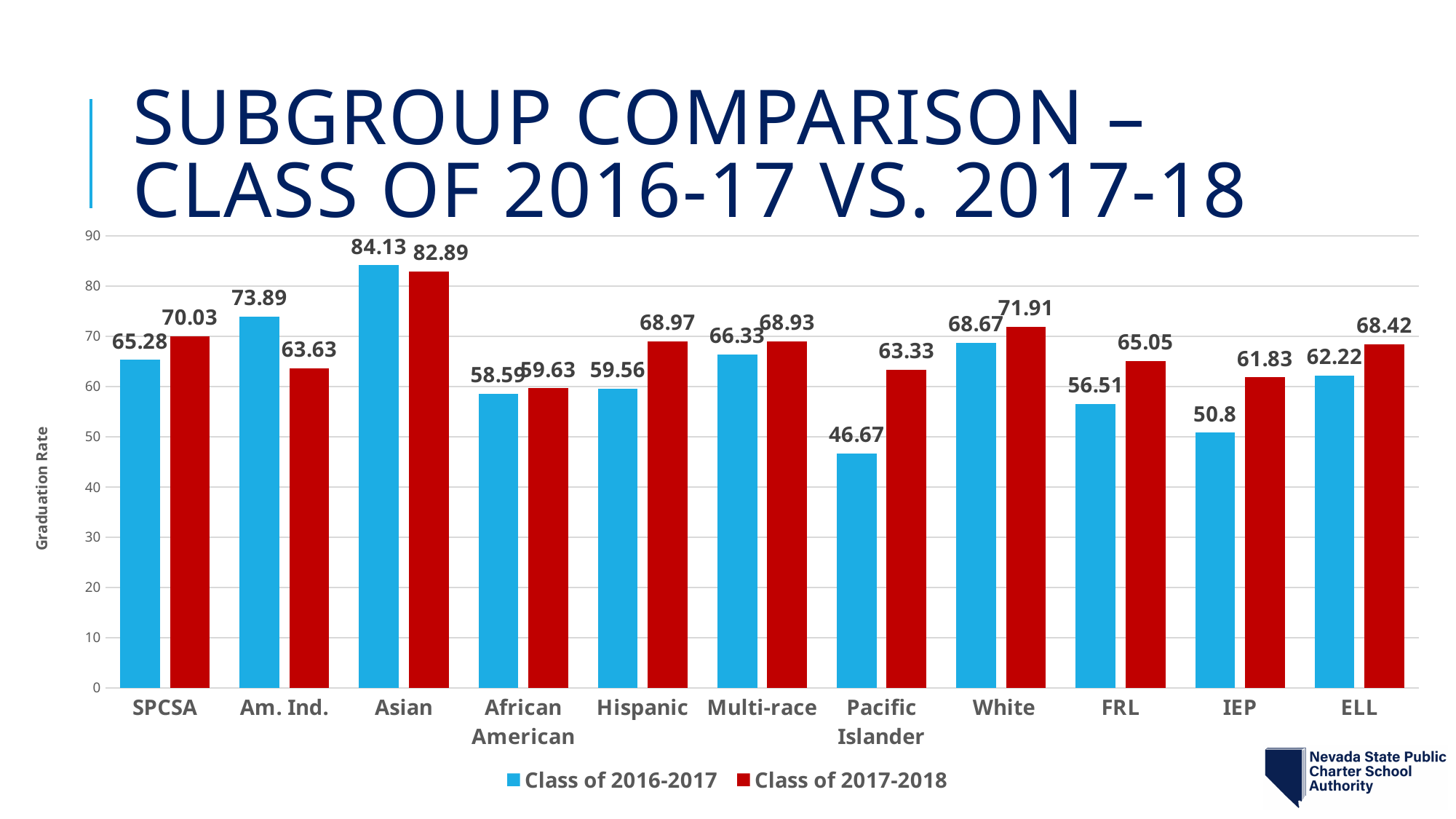
By how much did the Pacific Islander graduation rate increase from the Class of 2016-2017 to the Class of 2017-2018? 16.66 What is the label on the vertical axis of the chart? Graduation Rate What kind of chart is shown on the slide? bar chart How many series does the legend list? 2 How many subgroups are shown on the x axis of the chart? 11 Which subgroup has the highest graduation rate for the Class of 2016-2017? Asian For Am. Ind. students, which class had the higher graduation rate, 2016-2017 or 2017-2018? Class of 2016-2017 What is the difference between the IEP graduation rates for the Class of 2017-2018 and the Class of 2016-2017? 11.03 What is the graduation rate for Pacific Islander students in the Class of 2016-2017? 46.67 Which subgroup has the lowest graduation rate for the Class of 2016-2017? Pacific Islander Is the Class of 2016-2017 graduation rate for African American students greater or less than 60? less What is the graduation rate for White students in the Class of 2017-2018? 71.91